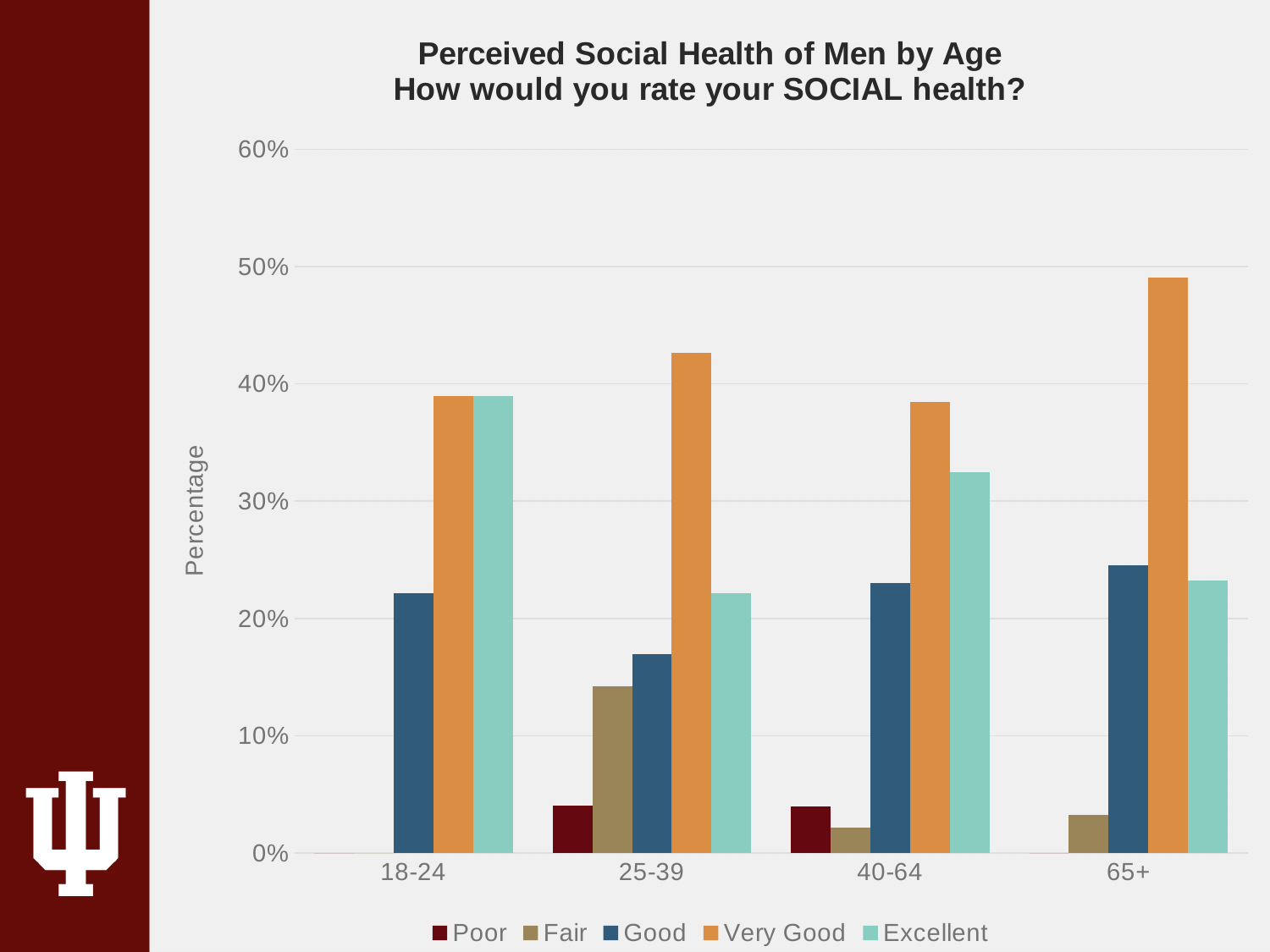
Is the Good value for 18-24 greater or less than 20%? greater Which age group has the highest Very Good bar? 65+ For the 40-64 age group, which is larger: Excellent or Good? Excellent What is the label on the y axis? Percentage For the 25-39 age group, which is larger: Very Good or Excellent? Very Good How many age groups are shown on the x axis? 4 Which age group has the lowest Good bar? 25-39 What kind of chart is shown on the slide? bar chart Is the Fair value for 25-39 greater or less than 10%? greater How many series does the legend list? 5 Is the Very Good value for 65+ greater or less than 40%? greater